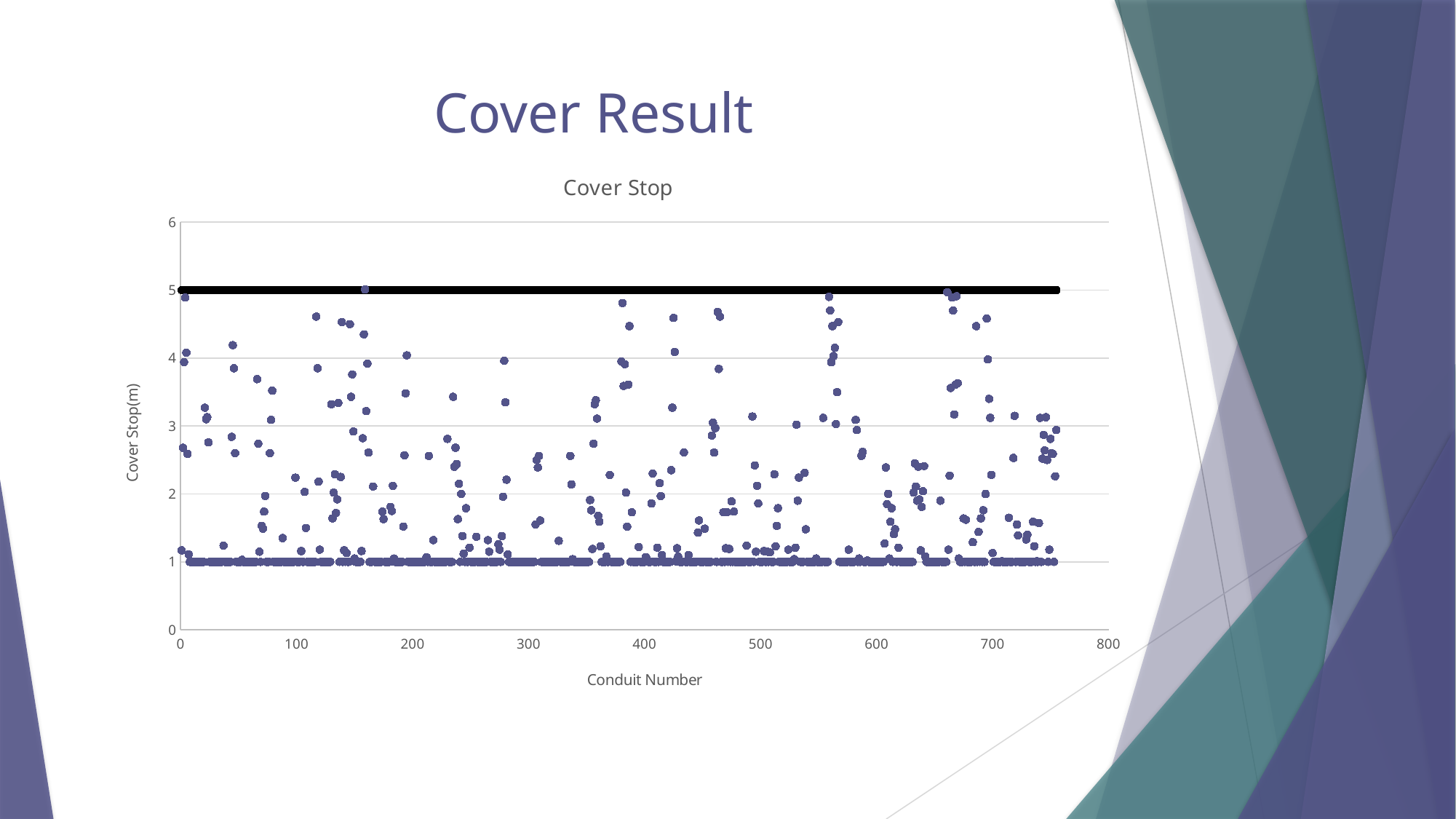
What is the title of the chart? Cover Stop At what value on the y axis does the horizontal black line sit? 5 Is the highest plotted point greater or less than 6 on the y axis? less What is the maximum value shown on the y axis? 6 Is the horizontal black line greater or less than 4 on the y axis? greater What is the maximum value shown on the x axis? 800 Is the dense band of points at the bottom of the chart greater or less than 2 on the y axis? less At what y-axis value do the majority of the plotted points cluster? 1 What is the label of the x axis? Conduit Number What kind of chart is shown on the slide? scatter chart